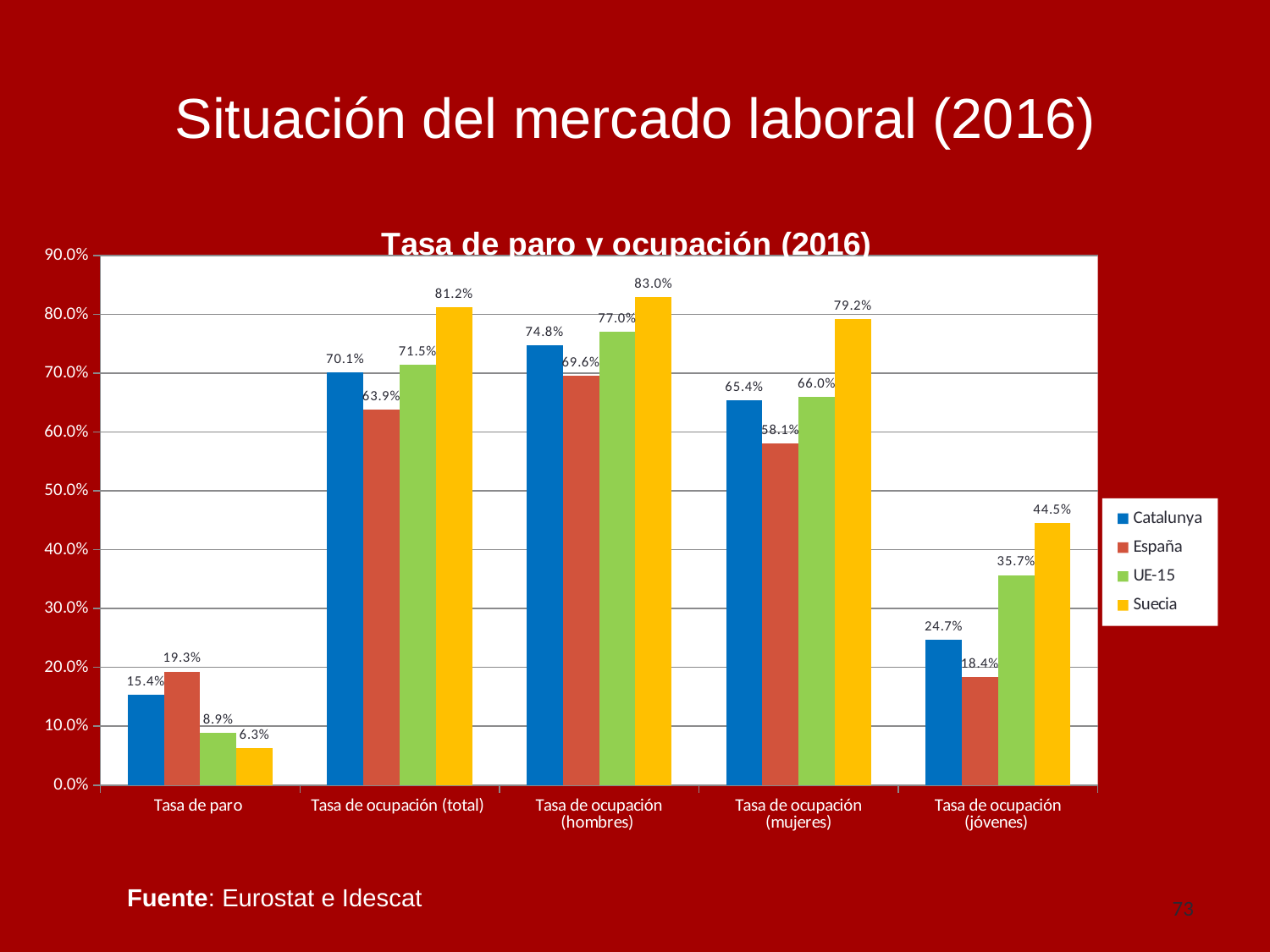
What is the value for UE-15 in the Tasa de ocupación (jóvenes) category? 35.7% What is the title of the chart? Tasa de paro y ocupación (2016) What is the value for Suecia in the Tasa de ocupación (hombres) category? 83.0% What kind of chart is shown on the slide? Bar chart What is the value for España in the Tasa de paro category? 19.3% Which colour represents Suecia in the legend? Yellow What is the difference between the Suecia and Catalunya values in the Tasa de ocupación (total) category? 11.1% Which series has the lowest value in the Tasa de paro category? Suecia In the Tasa de ocupación (jóvenes) category, which is larger: the value for Catalunya or the value for España? Catalunya Which series has the highest value in the Tasa de ocupación (mujeres) category? Suecia How many categories are shown on the x axis? 5 How many series does the legend list? 4